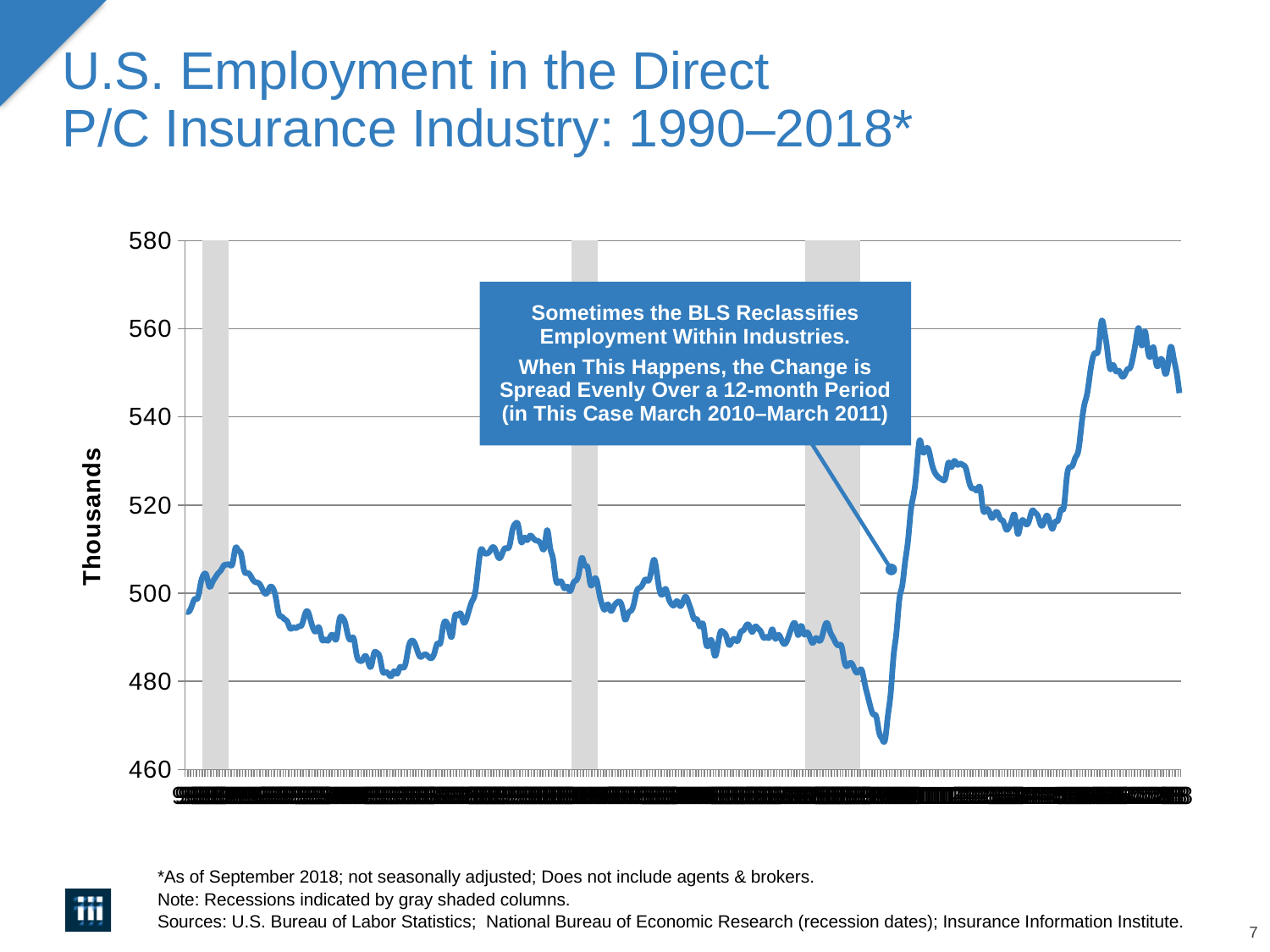
Is the value at the rightmost point of the line greater or less than 540? greater Which is larger, the value at the leftmost point of the line or the value at the rightmost point? the rightmost point Is the highest value reached by the line greater or less than 540? greater Is the lowest value reached by the line greater or less than 460? greater Which is larger, the value at the leftmost point of the line or the lowest value on the line? the leftmost point How many gray shaded recession columns appear on the chart? 3 What kind of chart is shown on the slide? line chart Overall, from the left end of the chart to the right end, do the values rise or fall? rise What is the label on the vertical axis of the chart? Thousands